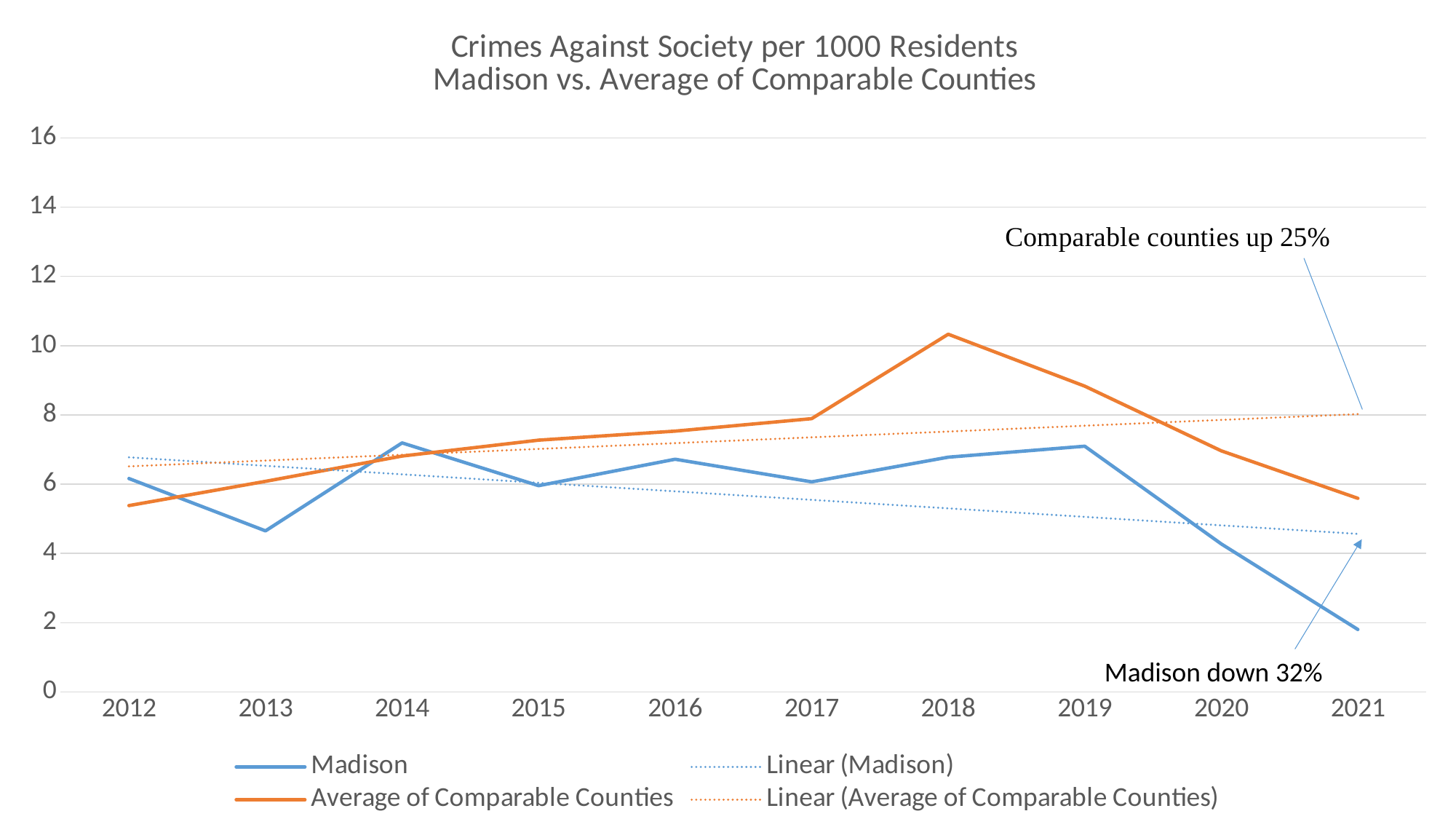
Is the value for Madison in 2013 greater or less than 6? less In which year does the Average of Comparable Counties line reach its highest value? 2018 What kind of chart is shown on the slide? line chart In 2021, which is higher: Madison or Average of Comparable Counties? Average of Comparable Counties Does the Linear (Madison) trend line rise or fall from 2012 to 2021? fall Is the value for Average of Comparable Counties in 2018 greater or less than 10? greater According to the annotation on the chart, by what percentage is Madison down? 32% In 2012, which is higher: Madison or Average of Comparable Counties? Madison Is the value for Madison in 2021 greater or less than 2? less How many entries does the legend list? 4 How many years are plotted along the x axis? 10 In which year does the Madison line reach its lowest value? 2021